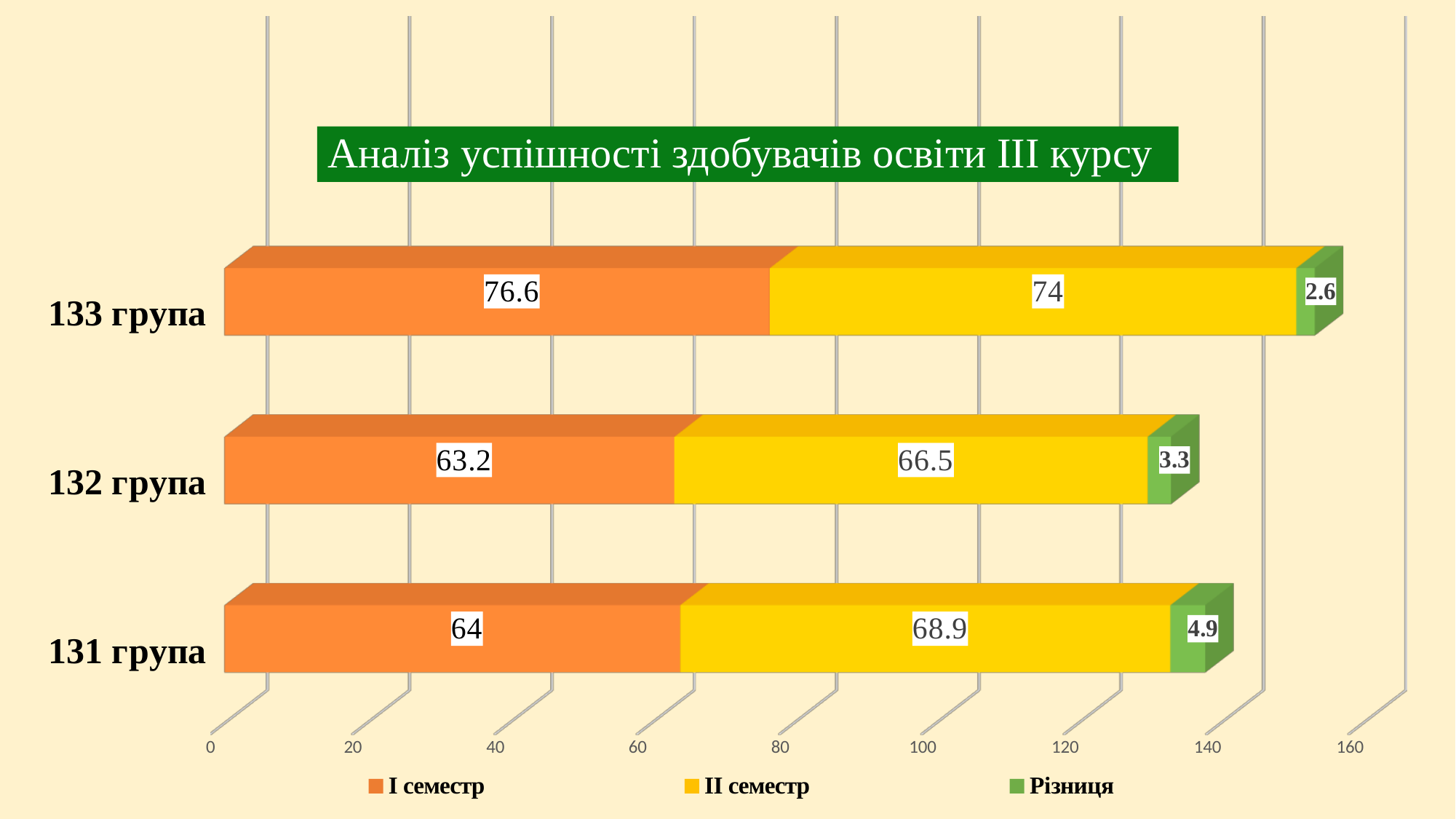
What is the total of the stacked bar for 132 група? 133 What is the title of the chart? Аналіз успішності здобувачів освіти ІІІ курсу How many groups are shown on the chart? 3 What is the value of ІІ семестр for 132 група? 66.5 What kind of chart is shown on the slide? Stacked bar chart Which group has the lowest Різниця value? 133 група What is the value of І семестр for 133 група? 76.6 How many series does the legend list? 3 What is the difference between the ІІ семестр values for 133 група and 131 група? 5.1 What is the value of Різниця for 131 група? 4.9 Which group has the highest І семестр value? 133 група Which is larger: the І семестр value for 132 група or the І семестр value for 131 група? 131 група